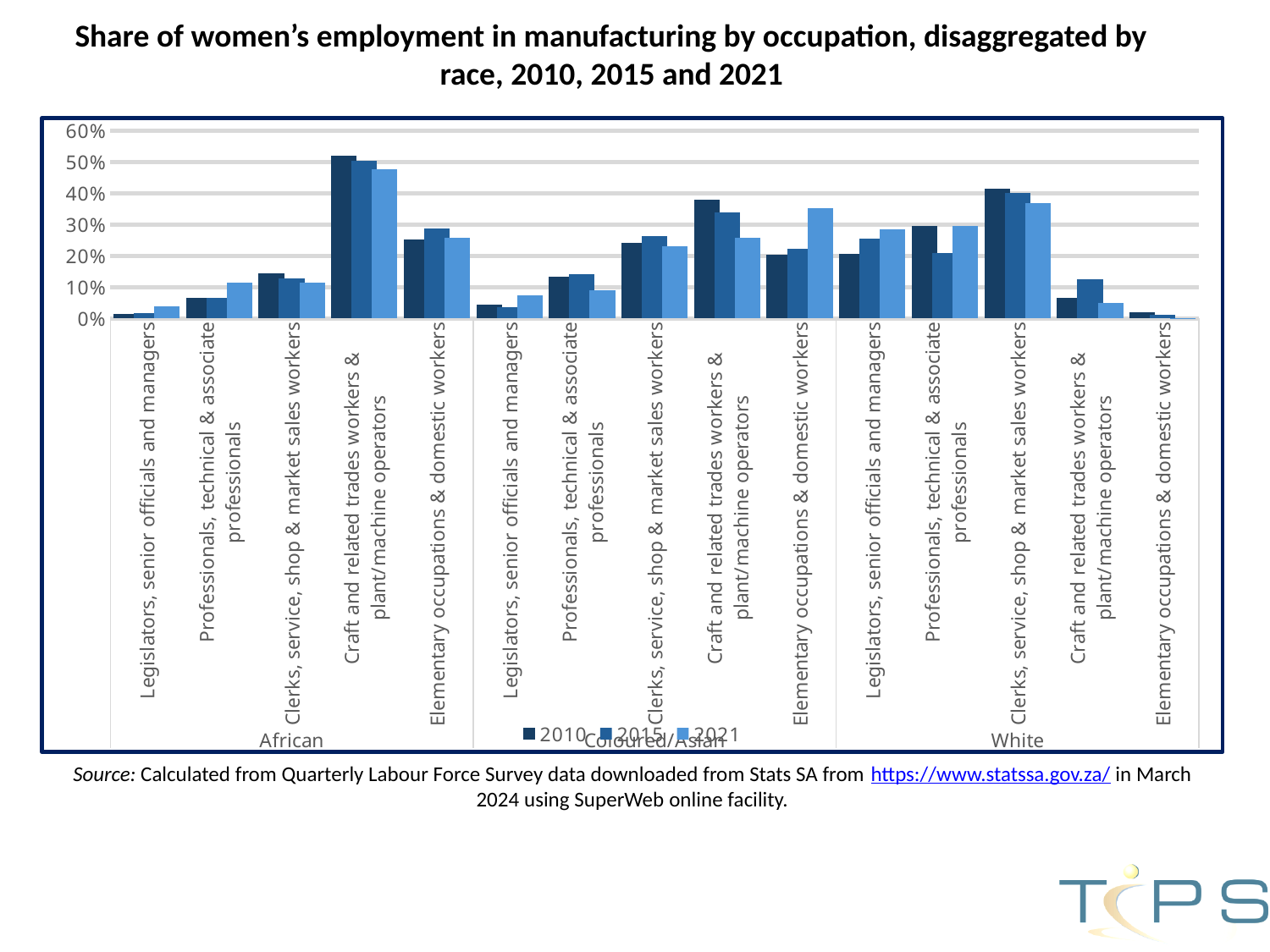
Does the share for African craft and related trades workers & plant/machine operators rise or fall from 2010 to 2021? fall For White professionals, technical & associate professionals, which year has the larger value: 2010 or 2015? 2010 How many race groups are shown along the x axis? 3 How many occupation categories are shown within each race group? 5 For African women in 2010, which occupation has the highest share? Craft and related trades workers & plant/machine operators Which years are listed in the legend? 2010, 2015 and 2021 Does the share for Coloured/Asian elementary occupations & domestic workers rise or fall from 2010 to 2021? rise How many series does the legend list? 3 For White women in 2021, which occupation has the lowest share? Elementary occupations & domestic workers Is the 2021 value for White clerks, service, shop & market sales workers greater or less than 40%? less What kind of chart is shown on the slide? Bar chart Is the 2010 value for African craft and related trades workers & plant/machine operators greater or less than 50%? greater